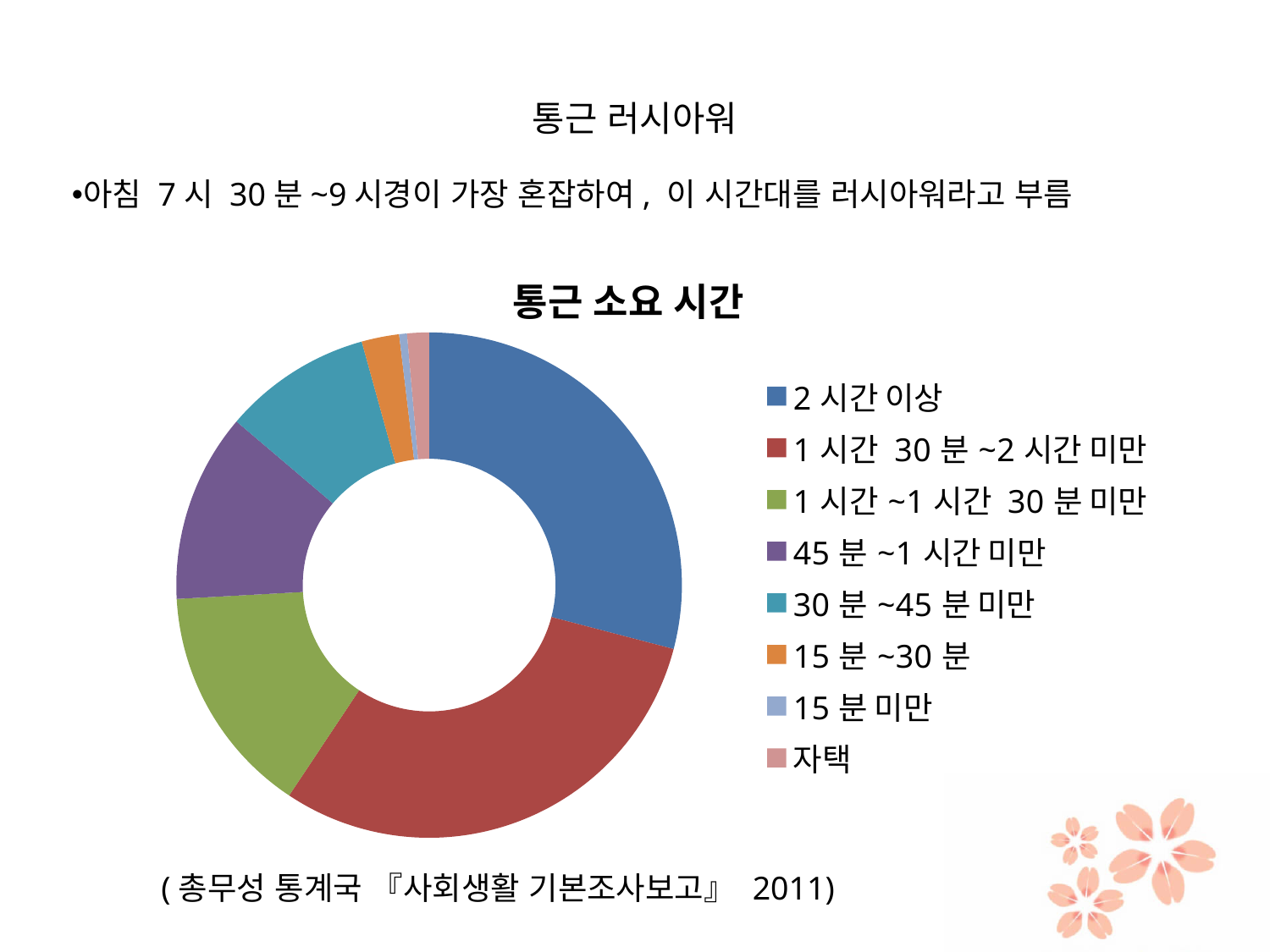
Which category is listed last in the chart's legend? 자택 Which slice is larger: 2 시간 이상 or 30 분 ~45 분 미만? 2 시간 이상 How many categories does the chart's legend list? 8 Which slice is larger: 1 시간 30 분 ~2 시간 미만 or 15 분 ~30 분? 1 시간 30 분 ~2 시간 미만 What kind of chart is shown on the slide? Doughnut (pie) chart Which slice is larger: 45 분 ~1 시간 미만 or 15 분 ~30 분? 45 분 ~1 시간 미만 Which category is shown in blue in the chart? 2 시간 이상 What is the title of the chart? 통근 소요 시간